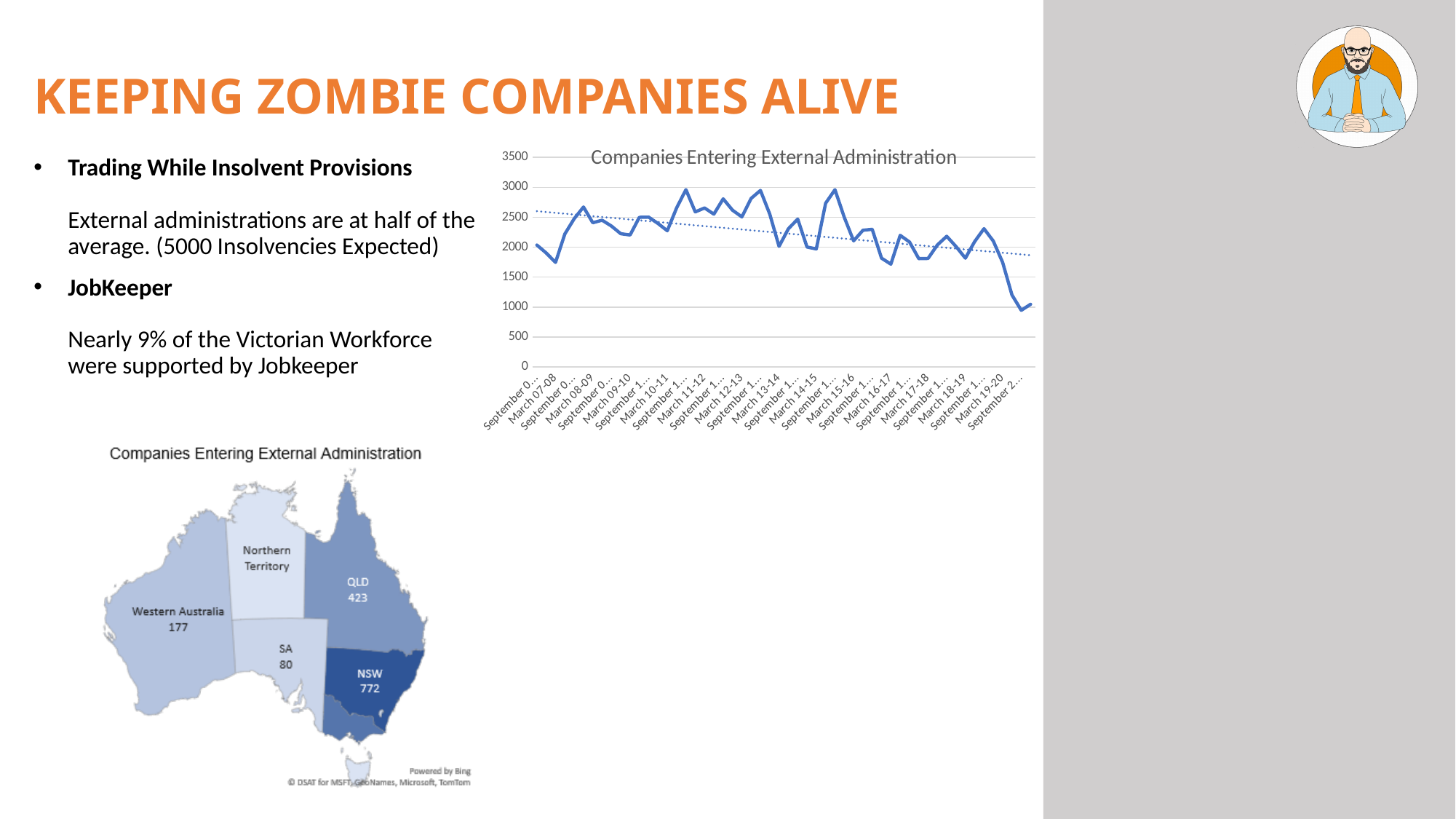
On the map chart at the bottom left, what is the value shown for SA? 80 On the map chart at the bottom left, what is the difference between the values for NSW and QLD? 349 What kind of chart is the chart at the top right of the slide? Line chart On the map chart at the bottom left, which labelled state has the highest number of companies entering external administration? NSW On the map chart at the bottom left, how many states or territories have a numeric value printed? 4 On the map chart at the bottom left, which has a larger value, QLD or Western Australia? QLD On the map chart at the bottom left, what is the value shown for Western Australia? 177 On the line chart at the top right, do the values overall rise or fall from left to right along the x axis? Fall On the map chart at the bottom left, what is the value shown for NSW? 772 On the line chart at the top right, is the value at the last point on the line greater or less than 1500? less On the map chart at the bottom left, what is the value shown for QLD? 423 On the map chart at the bottom left, which labelled state has the lowest value? SA